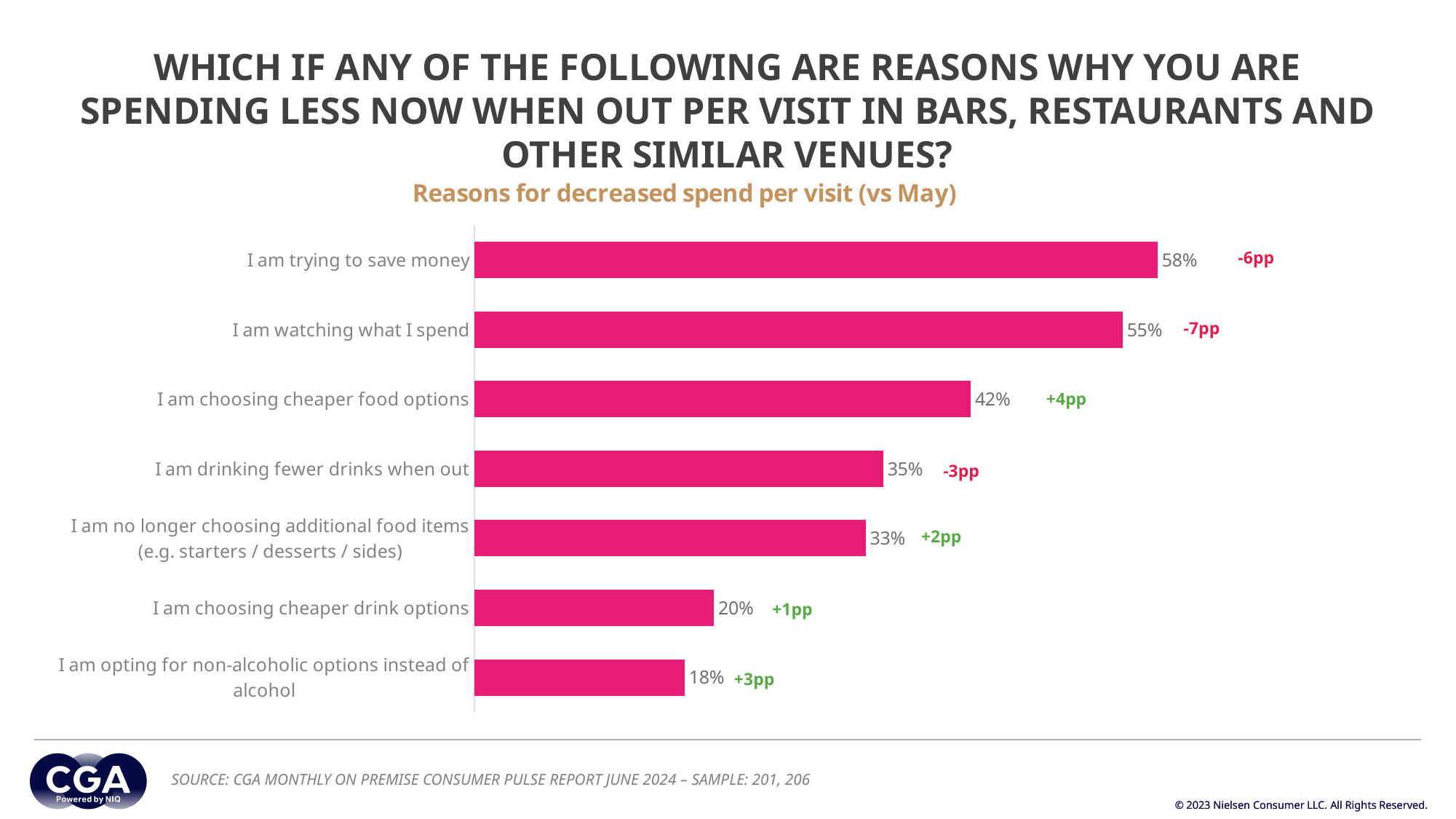
What is the change versus May shown next to "I am watching what I spend"? -7pp What percentage is shown for "I am opting for non-alcoholic options instead of alcohol"? 18% Which is larger: the value for "I am drinking fewer drinks when out" or the value for "I am no longer choosing additional food items (e.g. starters / desserts / sides)"? I am drinking fewer drinks when out Which reason has the highest percentage in the chart? I am trying to save money Which reason has the lowest percentage in the chart? I am opting for non-alcoholic options instead of alcohol What is the difference between the values for "I am drinking fewer drinks when out" and "I am choosing cheaper drink options"? 15 percentage points What type of chart is shown on the slide? Bar chart What is the subtitle of the chart shown in orange text? Reasons for decreased spend per visit (vs May) What is the value shown for "I am choosing cheaper food options"? 42% How many reasons (categories) are plotted in the chart? 7 What is the difference in percentage points between "I am trying to save money" and "I am watching what I spend"? 3 percentage points What percentage of respondents said "I am trying to save money" as a reason for spending less per visit? 58%